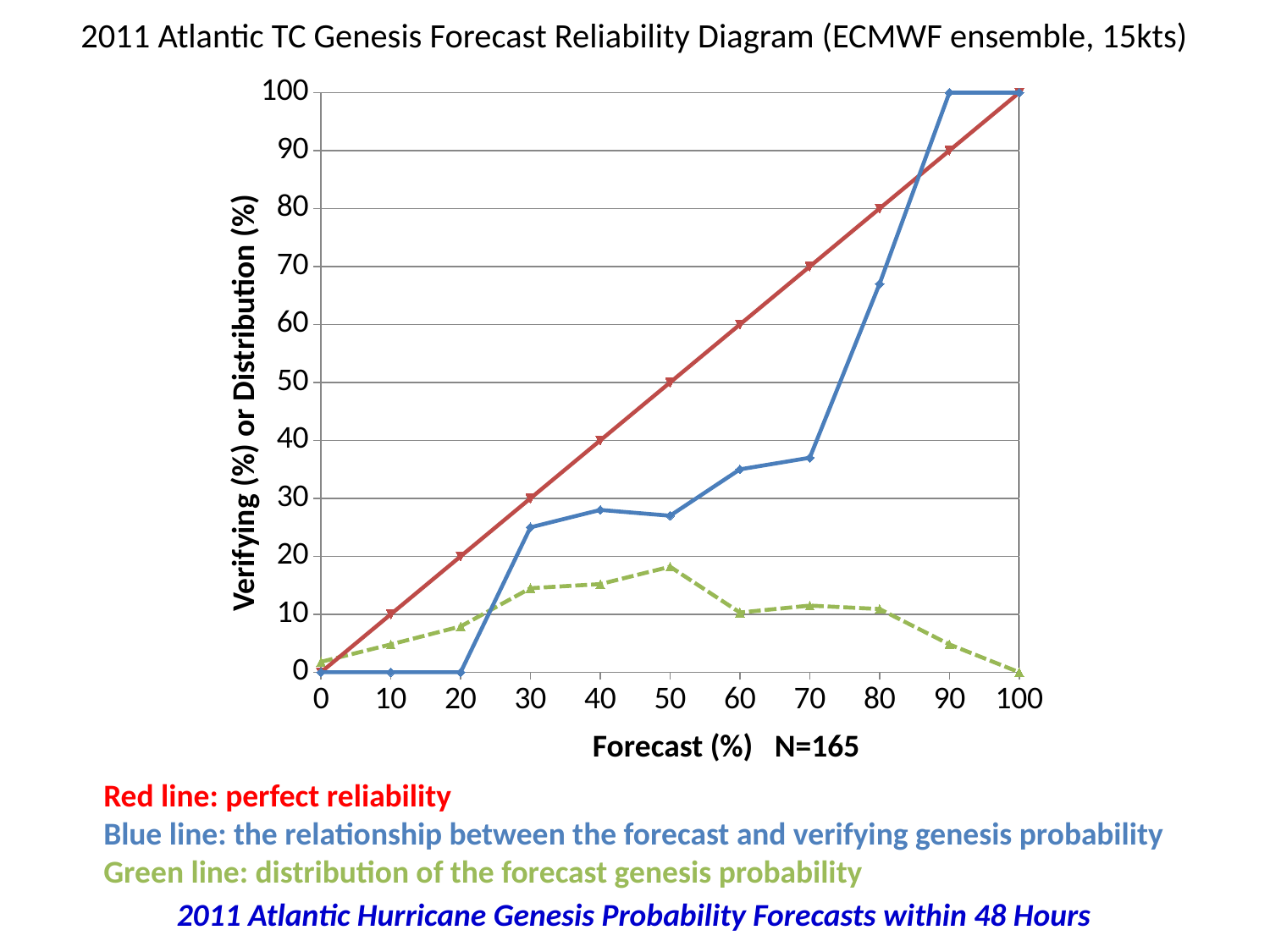
What is the value of the blue line at a forecast of 90%? 100 Is the value of the blue line at a forecast of 80% greater or less than 60? greater What kind of chart is shown on the slide? line chart At which forecast (%) does the green dashed line reach its highest value? 50 Is the value of the green dashed line at a forecast of 50% greater or less than 20? less How many forecast (%) values are marked along the x axis? 11 What is the value of the red line at a forecast of 50%? 50 Is the value of the blue line at a forecast of 70% greater or less than 40? less What is the N value shown in the x-axis label? N=165 At a forecast of 70%, which line has the higher value, the red line or the blue line? red line What is the value of the blue line at a forecast of 20%? 0 How many lines are plotted on the chart? 3